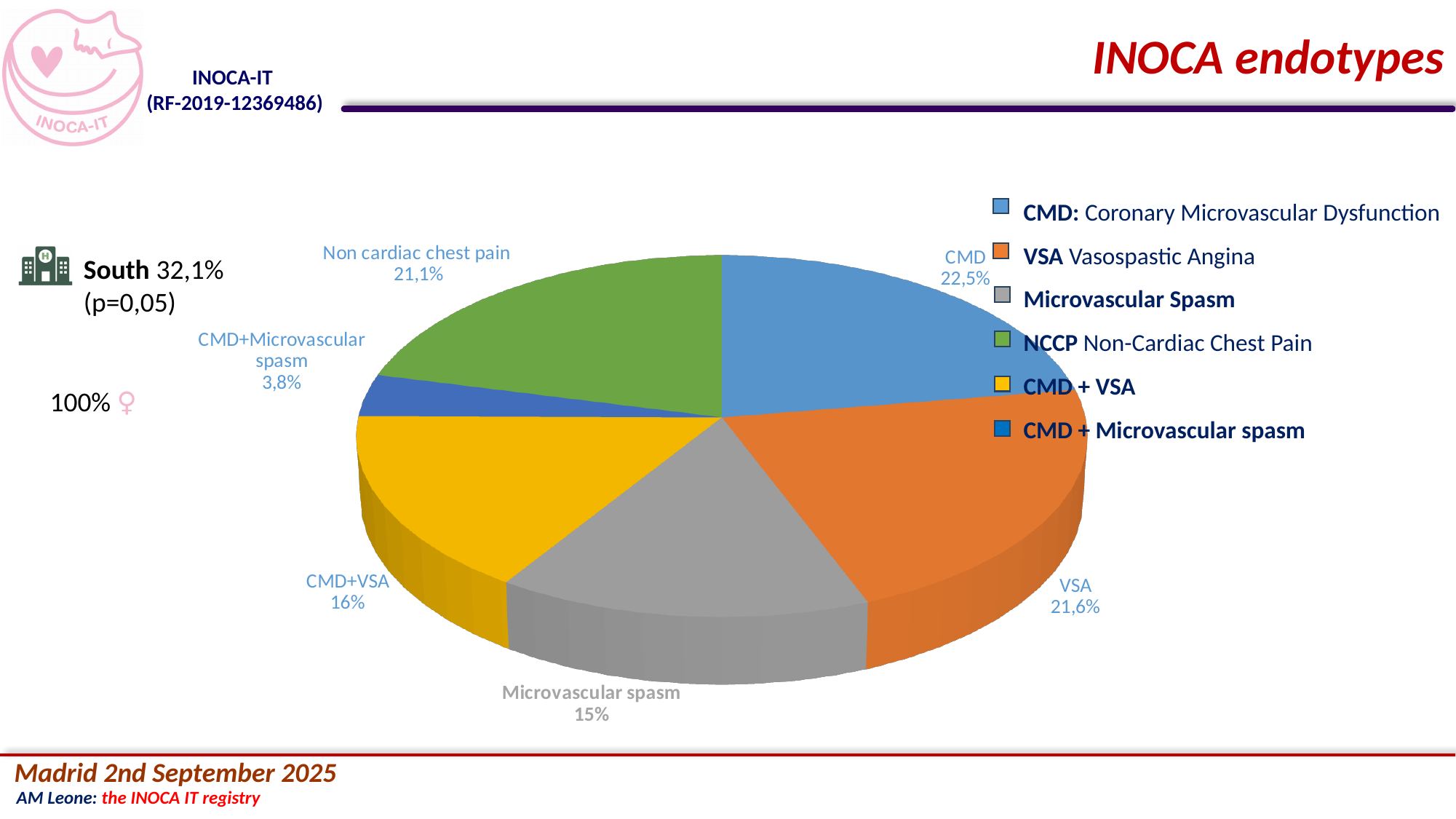
What share of the pie does CMD+Microvascular spasm represent? 3,8% What share of the pie does Non cardiac chest pain represent? 21,1% What share of the pie does Microvascular spasm represent? 15% What is the difference in percentage points between the CMD+VSA slice and the Microvascular spasm slice? 1 percentage point Which endotype has the largest slice of the pie? CMD How many slices does the pie chart have? 6 What share of the pie does CMD+VSA represent? 16% What kind of chart is shown on the slide? pie chart What share of the pie does VSA represent? 21,6% Which colour is used for the NCCP (Non-Cardiac Chest Pain) slice? green What share of the pie does CMD represent? 22,5% Which endotype has the smallest slice of the pie? CMD+Microvascular spasm